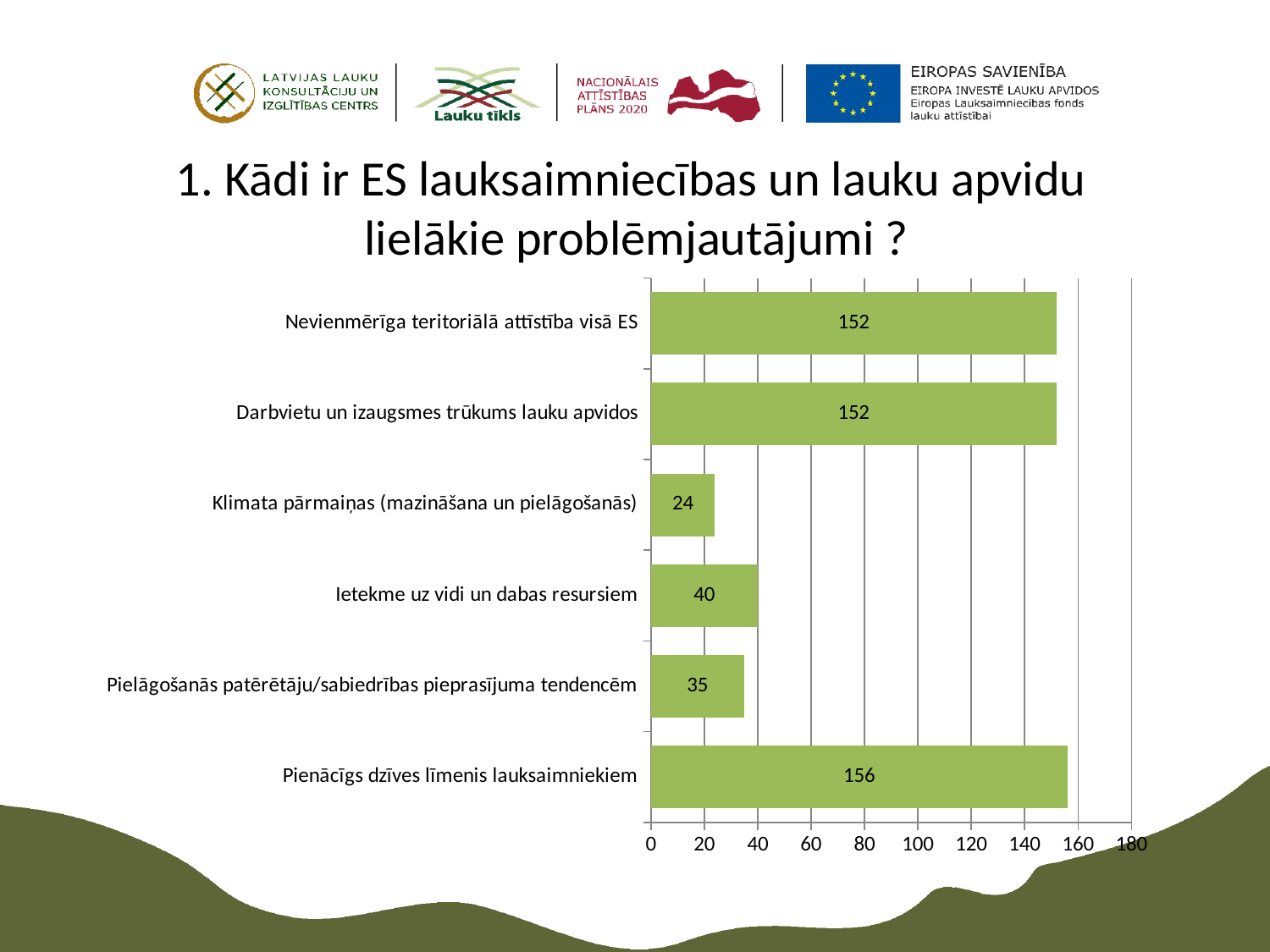
What is the value for "Klimata pārmaiņas (mazināšana un pielāgošanās)"? 24 What is the value for "Pielāgošanās patērētāju/sabiedrības pieprasījuma tendencēm"? 35 Which is larger: the value for "Ietekme uz vidi un dabas resursiem" or for "Pielāgošanās patērētāju/sabiedrības pieprasījuma tendencēm"? Ietekme uz vidi un dabas resursiem What is the difference between the values for "Pienācīgs dzīves līmenis lauksaimniekiem" and "Nevienmērīga teritoriālā attīstība visā ES"? 4 What is the value for "Ietekme uz vidi un dabas resursiem"? 40 What kind of chart is shown on the slide? bar chart What is the value for "Pienācīgs dzīves līmenis lauksaimniekiem"? 156 Which category has the lowest value? Klimata pārmaiņas (mazināšana un pielāgošanās) Is the value for "Darbvietu un izaugsmes trūkums lauku apvidos" greater or less than 140? greater Which category has the highest value? Pienācīgs dzīves līmenis lauksaimniekiem What is the difference between the values for "Ietekme uz vidi un dabas resursiem" and "Klimata pārmaiņas (mazināšana un pielāgošanās)"? 16 How many categories are shown in the chart? 6